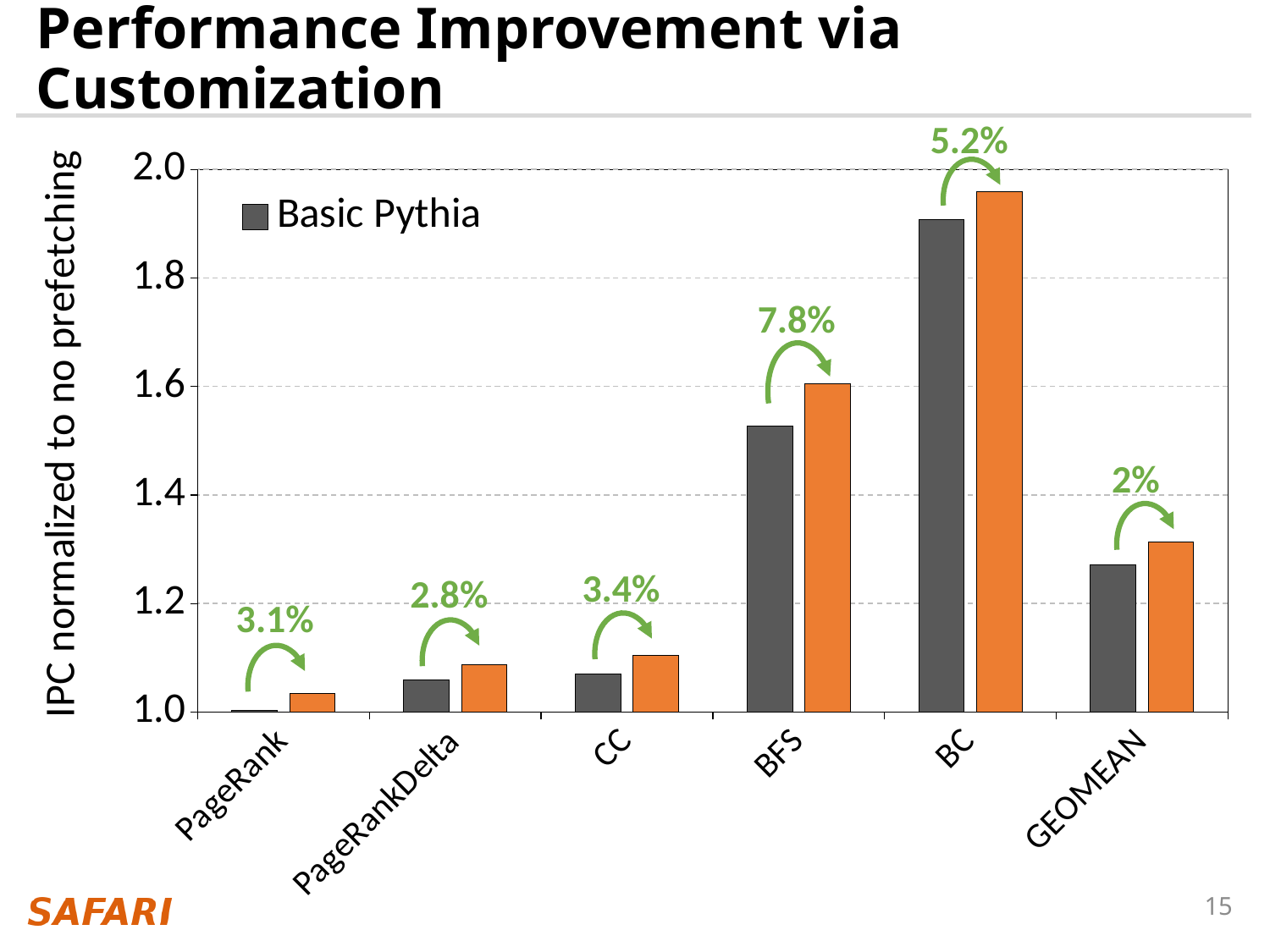
Which category has the largest annotated percentage improvement? BFS What percentage improvement is annotated above the BFS bars? 7.8% Which category has the lowest Basic Pythia bar? PageRank Which category has the highest Basic Pythia bar? BC What percentage improvement is annotated above the GEOMEAN bars? 2% What kind of chart is shown on the slide? bar chart What series name does the legend list? Basic Pythia How many categories are shown on the x axis? 6 What is the y-axis label of the chart? IPC normalized to no prefetching Is the Basic Pythia value for BFS greater or less than 1.4? greater Is the Basic Pythia value for BC greater or less than 1.8? greater What percentage improvement is annotated above the PageRankDelta bars? 2.8%